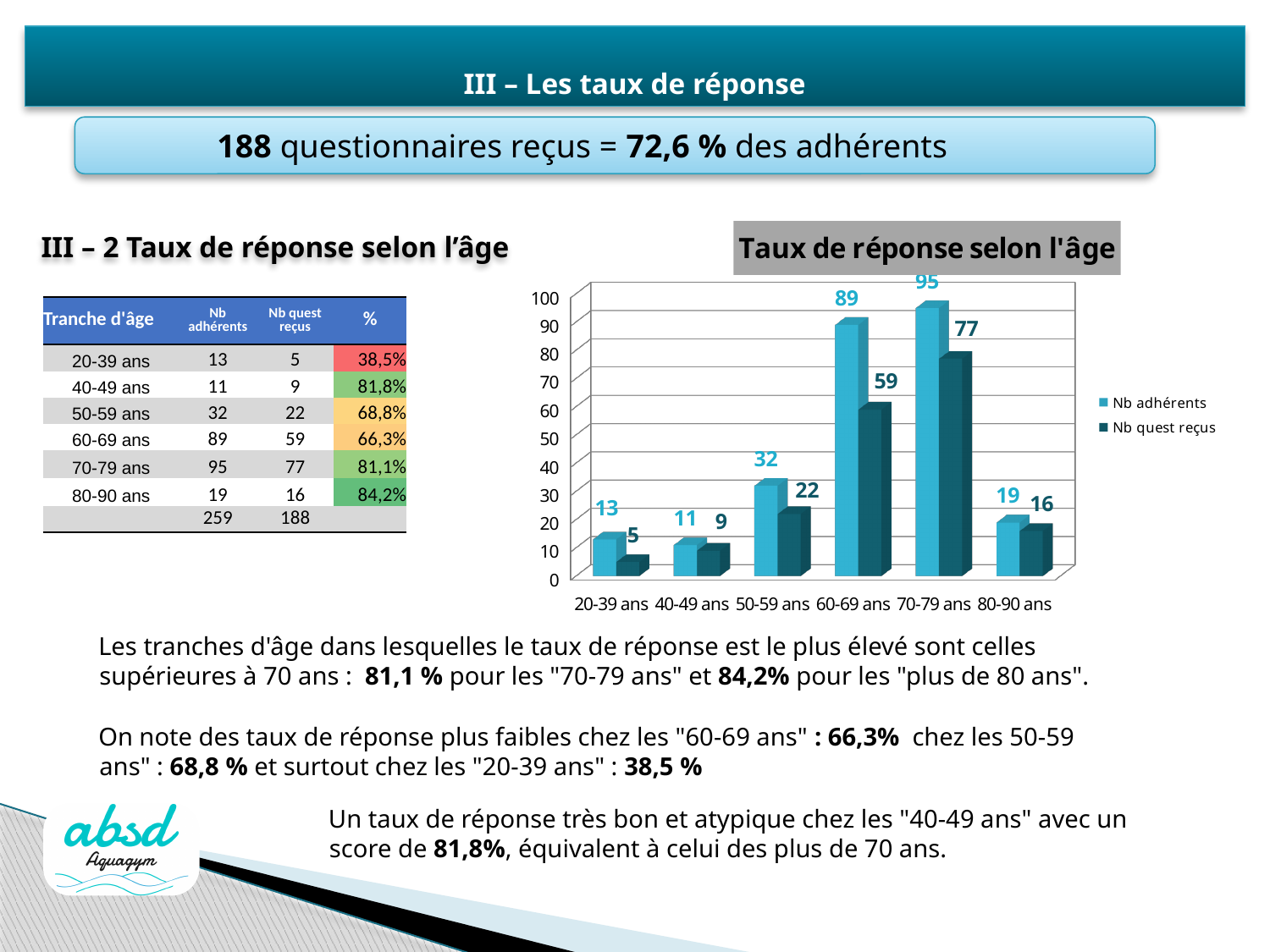
What is the value of Nb quest reçus for the 40-49 ans category? 9 Which age category has the highest Nb adhérents value? 70-79 ans What is the difference between Nb adhérents and Nb quest reçus for the 60-69 ans category? 30 Which age category has the lowest Nb quest reçus value? 20-39 ans Is the Nb adhérents value for 70-79 ans greater or less than 90? greater What is the value of Nb adhérents for the 60-69 ans category? 89 What is the value of Nb quest reçus for the 70-79 ans category? 77 What is the title of the chart? Taux de réponse selon l'âge How many age categories are shown on the x axis of the chart? 6 How many series does the chart legend list? 2 What kind of chart is shown on the slide? bar chart Which is larger for the 50-59 ans category: Nb adhérents or Nb quest reçus? Nb adhérents